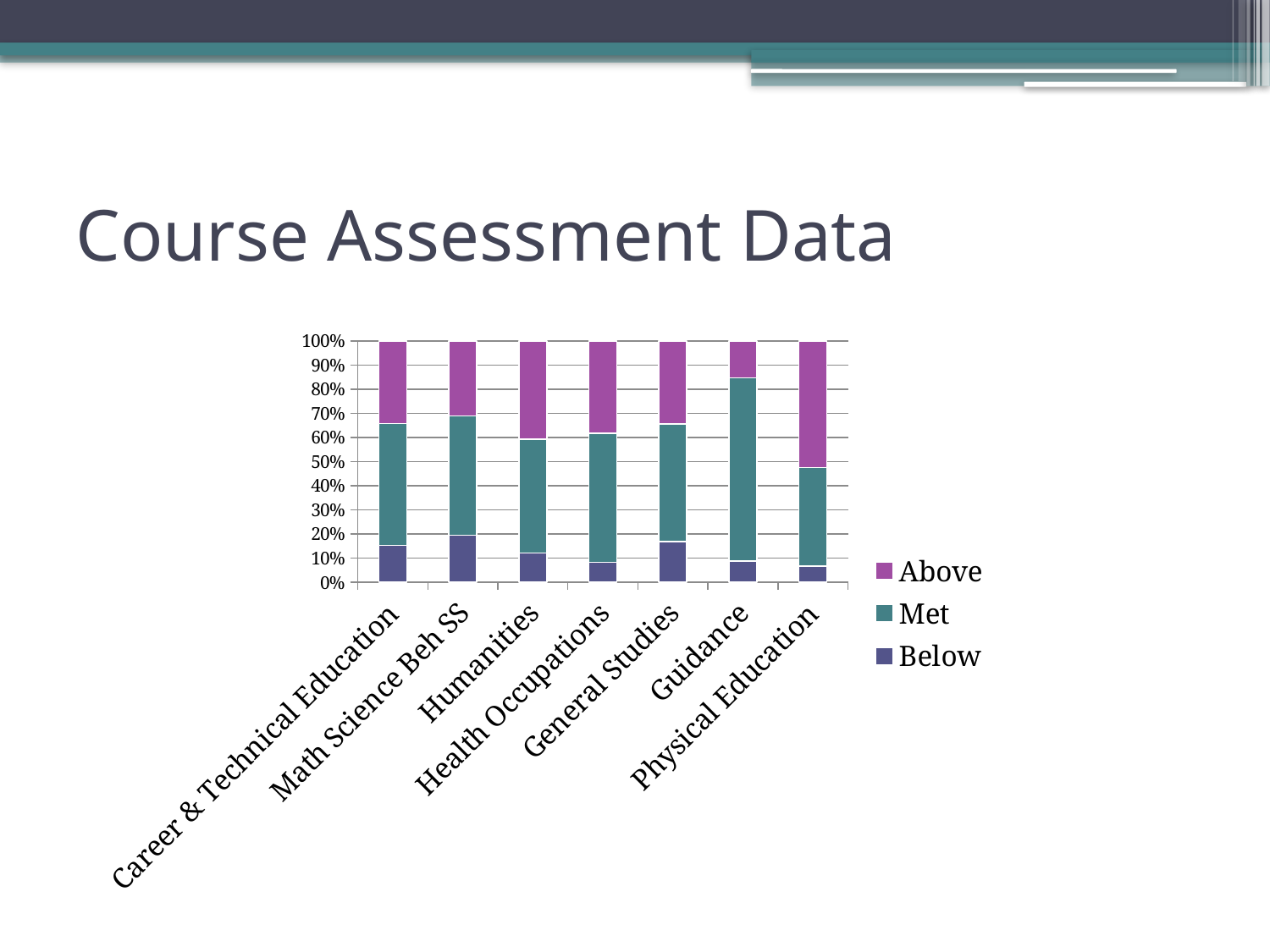
How many course categories are shown on the x axis of the chart? 7 Which category has the largest 'Met' segment? Guidance How many series does the chart's legend list? 3 Is the 'Below' value for Math Science Beh SS greater or less than 10%? greater What are the three series listed in the chart's legend? Above, Met, Below Which category has the smallest 'Above' segment? Guidance Which category has the smallest 'Met' segment? Physical Education Which has a larger 'Above' segment, Humanities or Math Science Beh SS? Humanities What is the title of the slide containing the chart? Course Assessment Data Is the 'Above' value for Guidance greater or less than 20%? less Which category has the largest 'Above' segment? Physical Education What kind of chart is shown on the slide? Stacked bar chart